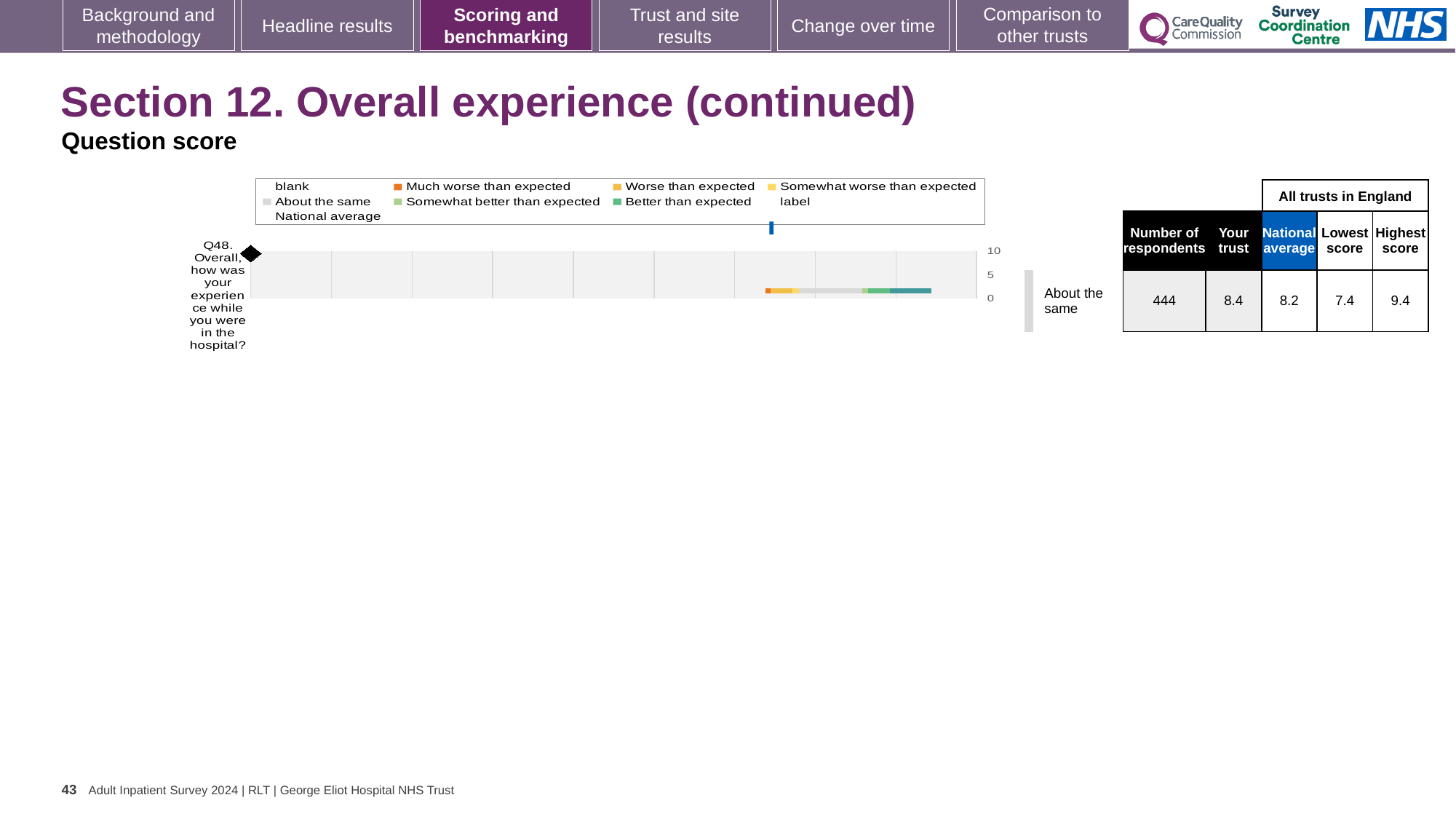
What is the national average score for Q48? 8.2 What kind of chart is shown on the slide? bar chart What is the 'Your trust' score for Q48? 8.4 What is the highest score among all trusts in England for Q48? 9.4 What is the lowest score among all trusts in England for Q48? 7.4 How many questions are plotted on the chart? 1 What is the difference between the highest and lowest scores among all trusts in England for Q48? 2.0 Which question is plotted on the chart? Q48. Overall, how was your experience while you were in the hospital? What is the highest value shown on the chart's axis? 10 Which is larger for Q48, the trust's score or the national average? the trust's score Is the trust's score for Q48 greater or less than 5 on the chart's axis? greater How many respondents answered Q48? 444